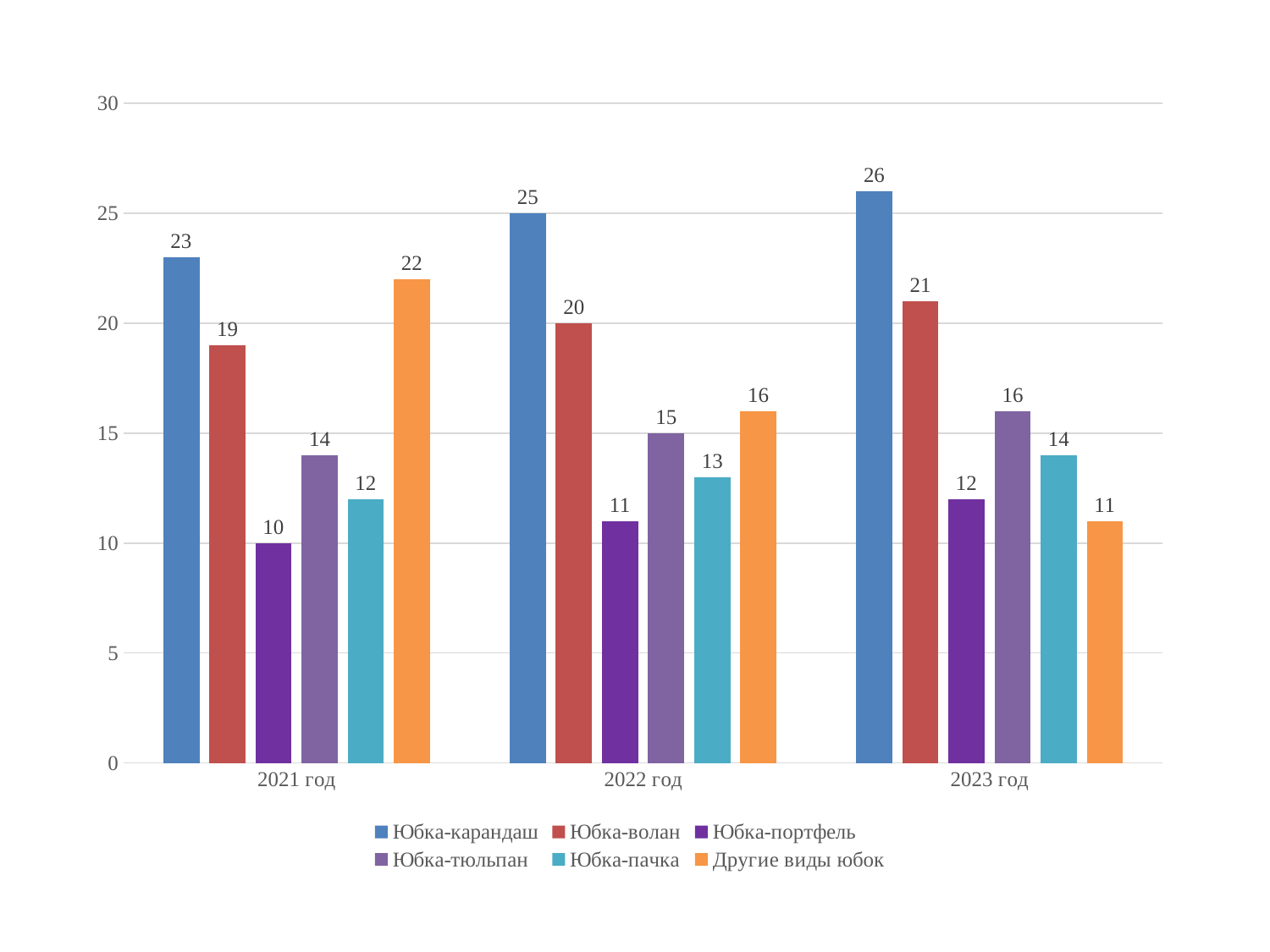
Does the value for Другие виды юбок rise or fall from 2021 год to 2023 год? Fall What is the value for Юбка-карандаш in 2021 год? 23 How many series does the legend list? 6 What is the difference between Юбка-карандаш and Юбка-волан in 2022 год? 5 Does the value for Юбка-карандаш rise or fall from 2021 год to 2023 год? Rise What kind of chart is this? Bar chart How many year categories are shown on the x axis? 3 What is the value for Юбка-тюльпан in 2022 год? 15 Which is larger in 2021 год: Юбка-волан or Другие виды юбок? Другие виды юбок Which series has the highest value in 2023 год? Юбка-карандаш Which series has the lowest value in 2021 год? Юбка-портфель What is the value for Другие виды юбок in 2023 год? 11